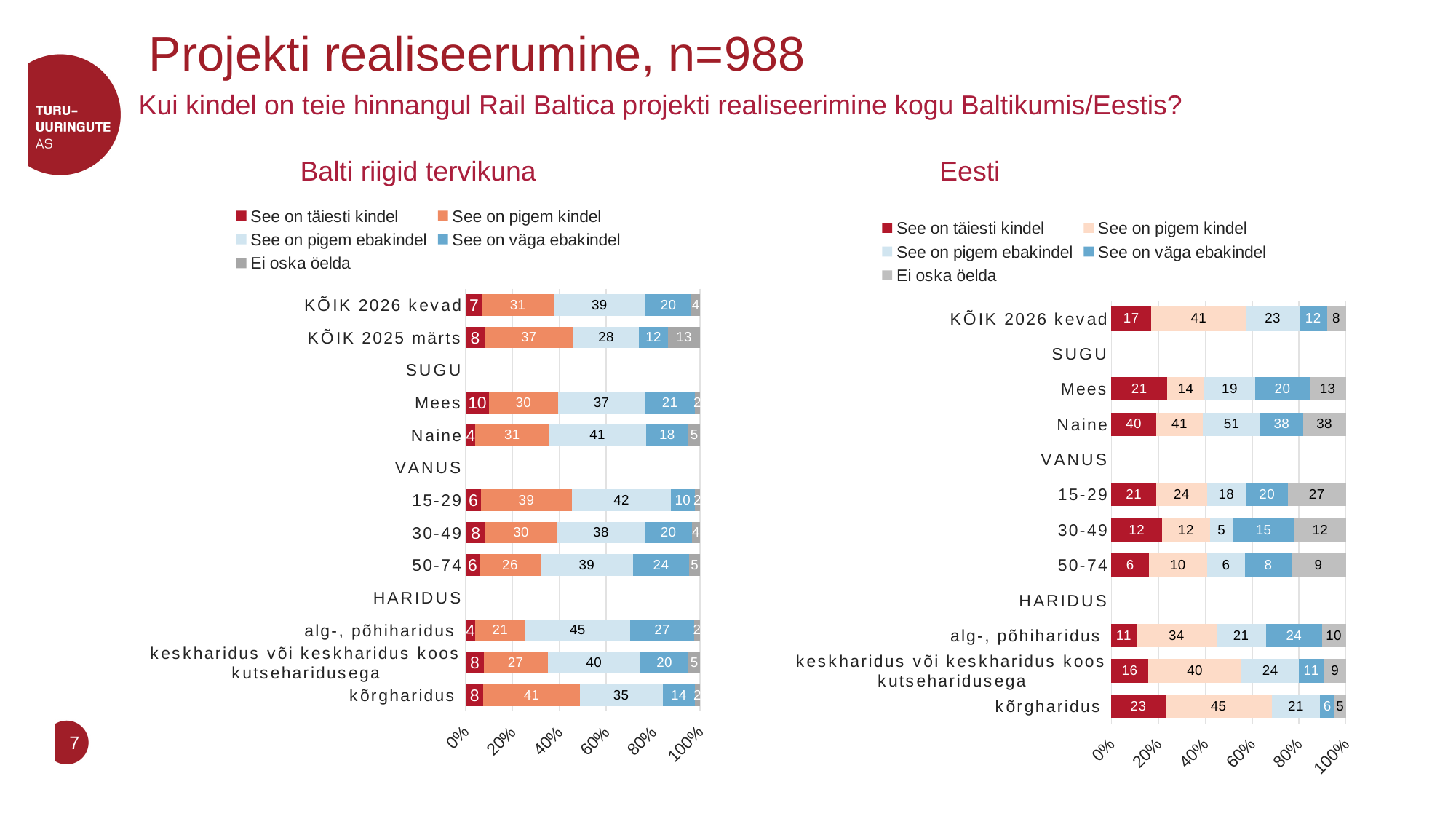
In the 'Eesti' chart, what is the value of 'See on väga ebakindel' for alg-, põhiharidus? 24 How many series does the legend of the 'Eesti' chart list? 5 In the 'Balti riigid tervikuna' chart, which category has the highest value for 'See on täiesti kindel'? Mees In the 'Balti riigid tervikuna' chart, what is the difference in 'See on pigem kindel' between KÕIK 2025 märts and KÕIK 2026 kevad? 6 In the 'Eesti' chart, which category has the highest value for 'Ei oska öelda'? Naine In the 'Eesti' chart, which is larger for 'See on pigem kindel': kõrgharidus or Mees? kõrgharidus In the 'Eesti' chart, what is the total of the stacked bar for kõrgharidus? 100 What kind of chart is the 'Balti riigid tervikuna' chart? Stacked bar chart In the 'Eesti' chart, what is the value of 'See on täiesti kindel' for kõrgharidus? 23 In the 'Balti riigid tervikuna' chart, what is the value of 'See on pigem ebakindel' for KÕIK 2026 kevad? 39 In the 'Balti riigid tervikuna' chart, which is larger for 'See on väga ebakindel': 50-74 or 15-29? 50-74 In the 'Balti riigid tervikuna' chart, what is the value of 'Ei oska öelda' for KÕIK 2025 märts? 13